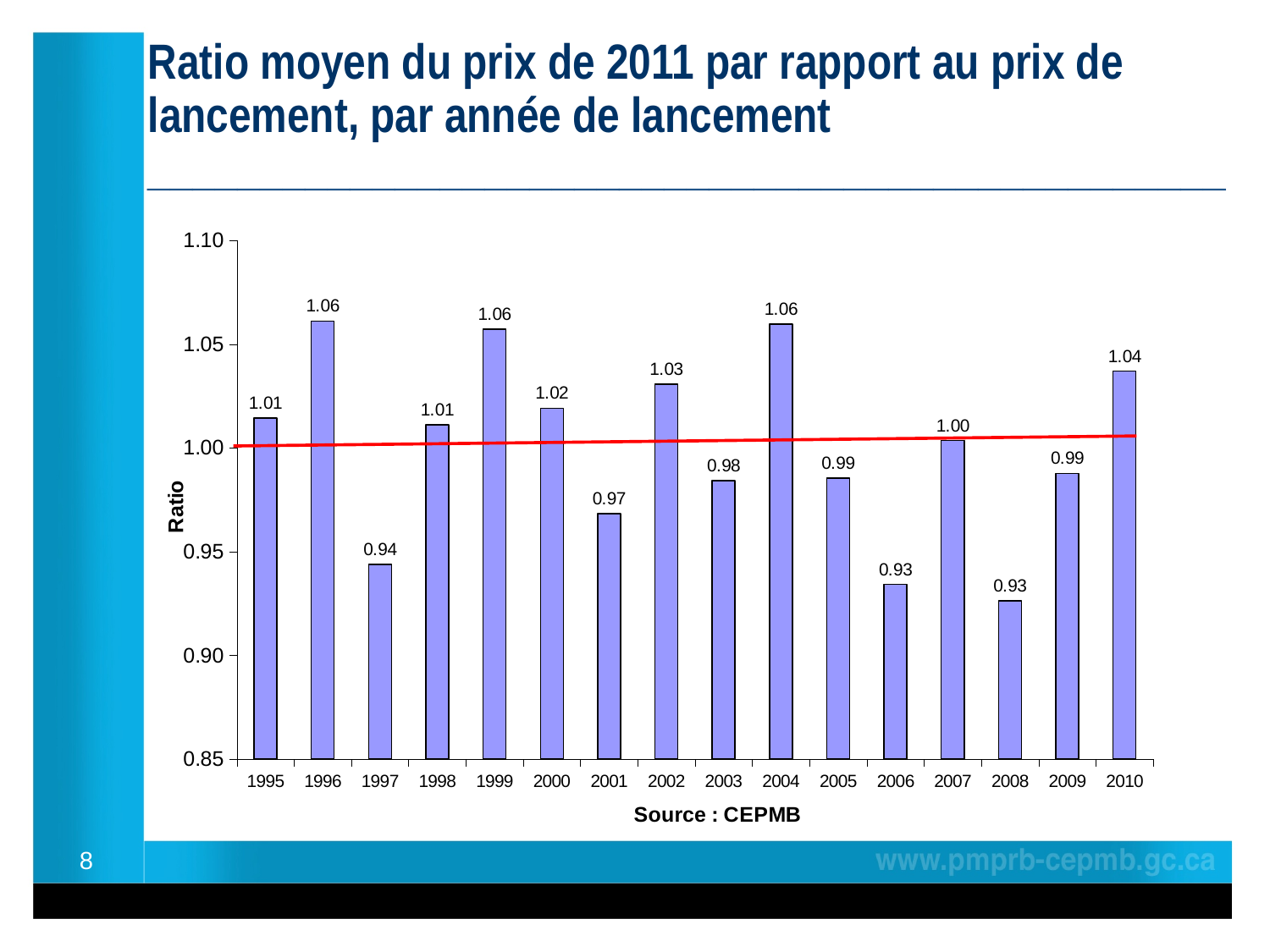
What is the ratio value for 1996? 1.06 How many launch years are shown on the x axis? 16 What is the ratio value for 2010? 1.04 What is the difference between the ratio for 1996 and the ratio for 1997? 0.12 What is the difference between the ratio for 2010 and the ratio for 2009? 0.05 Is the value for 2006 greater or less than 0.95? less Which year has the larger ratio, 1997 or 1998? 1998 What kind of chart is shown on the slide? bar chart Which year has the larger ratio, 2002 or 2003? 2002 What is the ratio value for 1997? 0.94 What is the ratio value for 2007? 1.00 What is the ratio value for 2001? 0.97